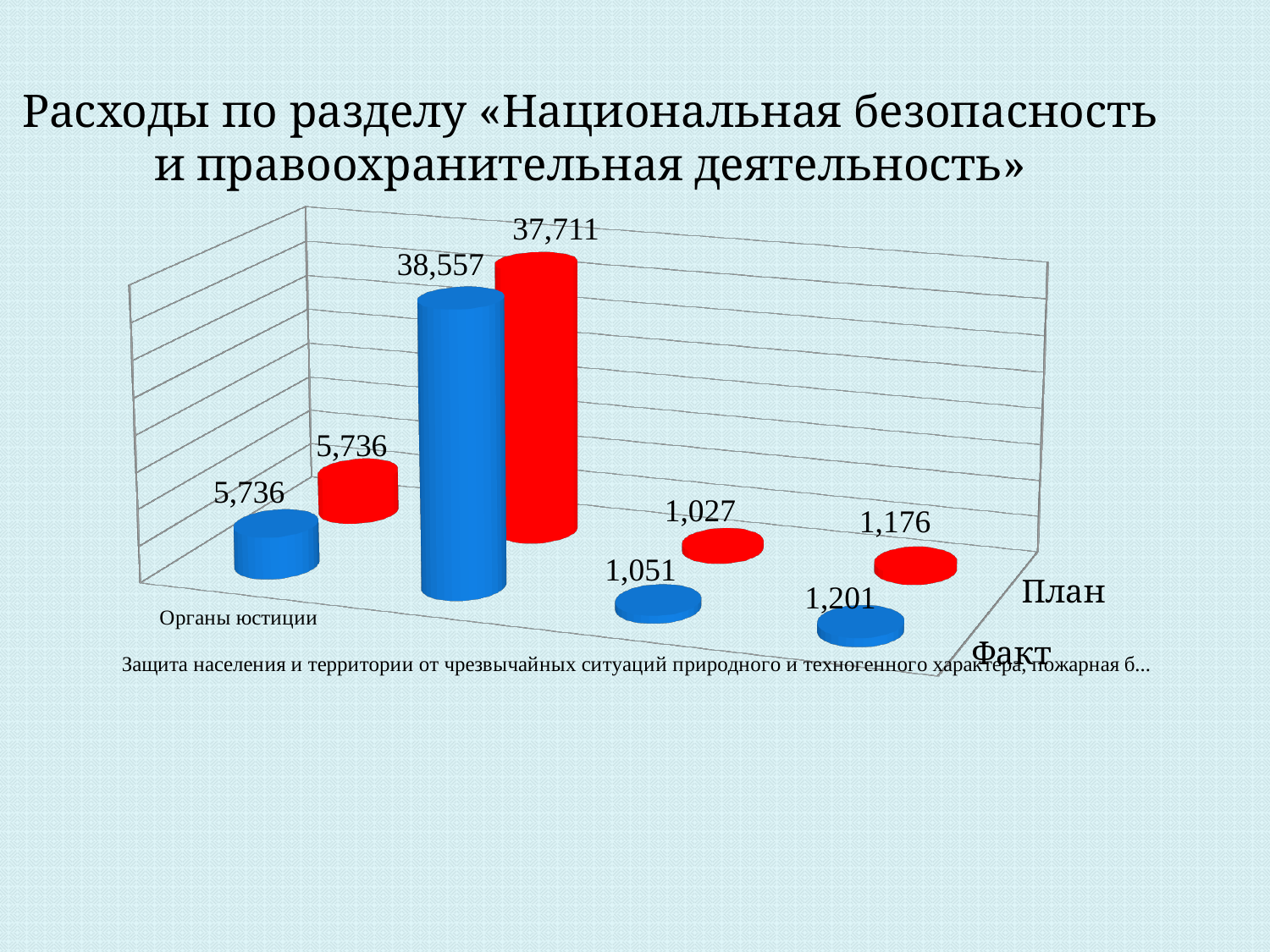
What colour are the План bars? Red How many series does the chart show? 2 What is the Факт value for Органы юстиции? 5,736 What is the Факт value for Защита населения и территории от чрезвычайных ситуаций? 1,051 How many categories are plotted on the chart? 4 By how much does the Факт value exceed the План value for Защита населения и территории от чрезвычайных ситуаций? 24 What is the План value for Защита населения и территории от чрезвычайных ситуаций? 1,027 What kind of chart is shown on the slide? Bar chart What is the План value for Органы юстиции? 5,736 What is the smallest value labelled on the chart? 1,027 For Защита населения и территории от чрезвычайных ситуаций, which is larger: План or Факт? Факт